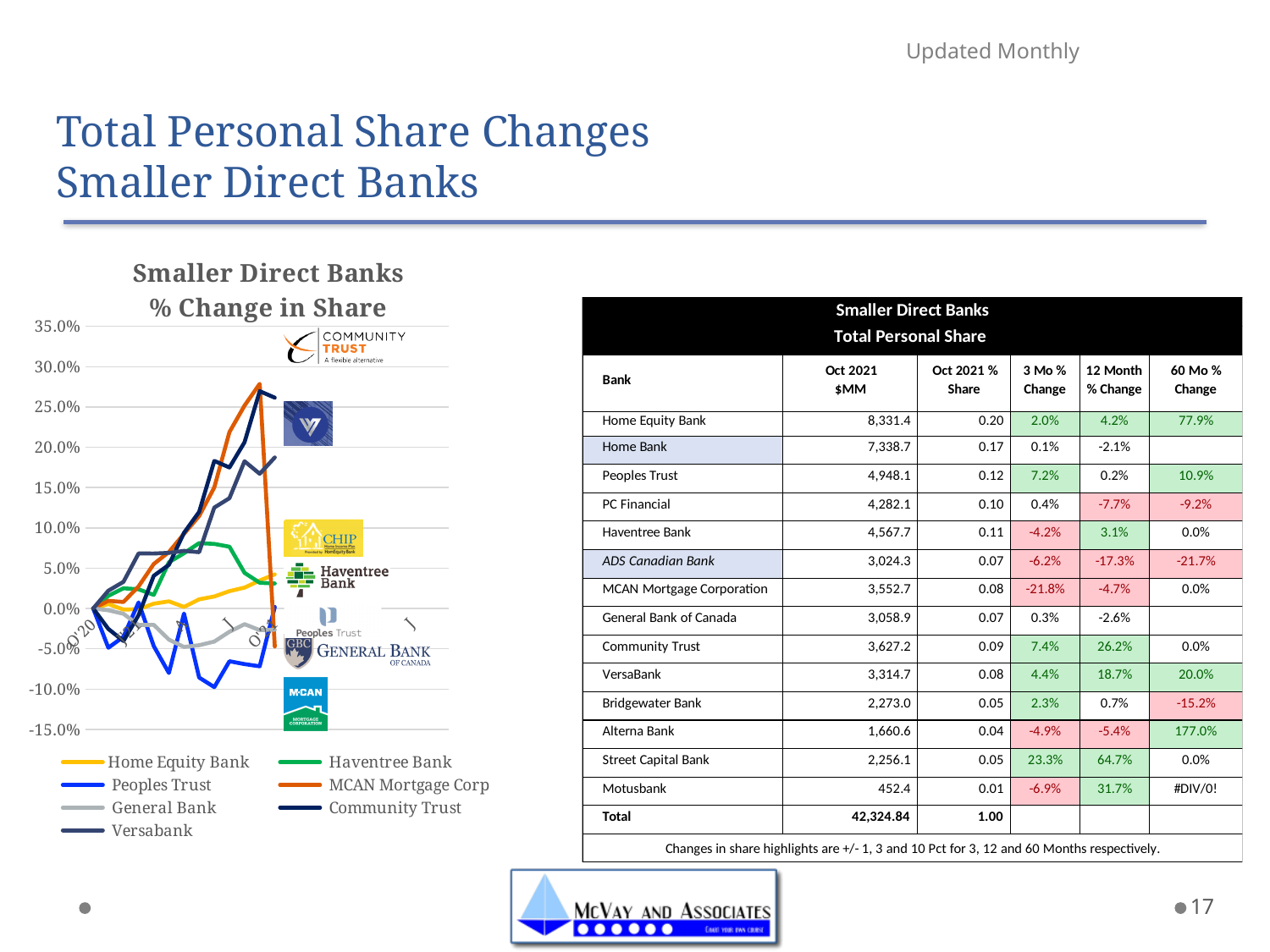
How many series does the legend of the "Smaller Direct Banks % Change in Share" chart list? 7 What kind of chart is shown on the slide? Line chart Is the peak of the MCAN Mortgage Corp line greater or less than 20.0%? greater What is the title of the chart on the left of the slide? Smaller Direct Banks % Change in Share Is the highest point of the Haventree Bank line greater or less than 10.0%? less What is the highest value shown on the y-axis of the chart? 35.0% Is the lowest point of the Peoples Trust line greater or less than -5.0%? less Which series in the chart is drawn in yellow? Home Equity Bank Which series reaches the lowest value on the chart? Peoples Trust